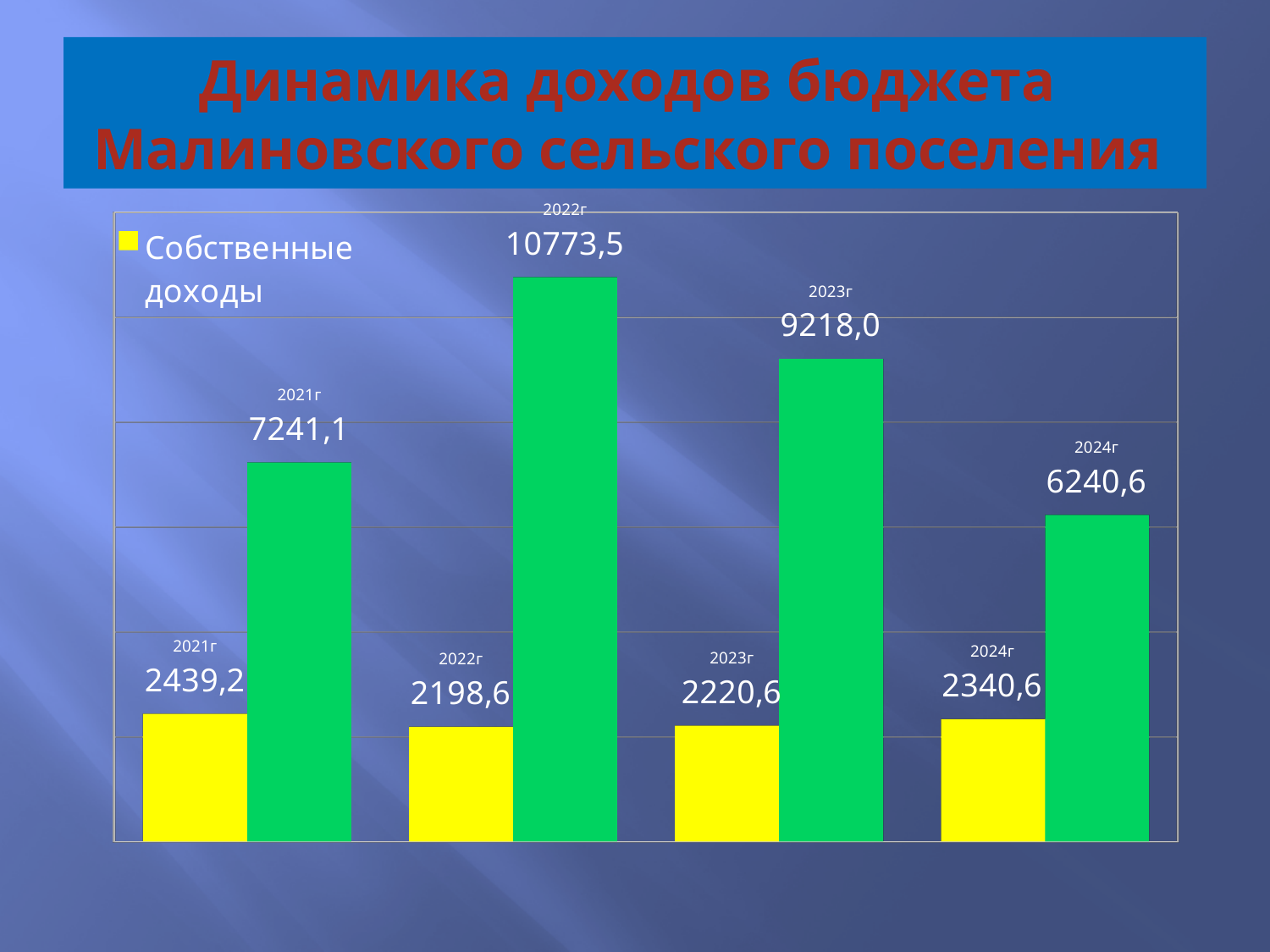
What is the difference between Собственные доходы in 2024г and 2023г? 120,0 What is the value of the green bar for 2024г? 6240,6 What is the value of Собственные доходы for 2021г? 2439,2 Do the green bar values rise or fall from 2022г to 2024г? fall What kind of chart is shown on the slide? bar chart What is the difference between the green bar values for 2022г and 2023г? 1555,5 In which year is the value of Собственные доходы lowest? 2022г How many series does the legend list? 1 In which year is the green bar highest? 2022г Which year has the larger value of Собственные доходы, 2021г or 2024г? 2021г How many years are shown on the chart? 4 What is the value of the green bar for 2022г? 10773,5